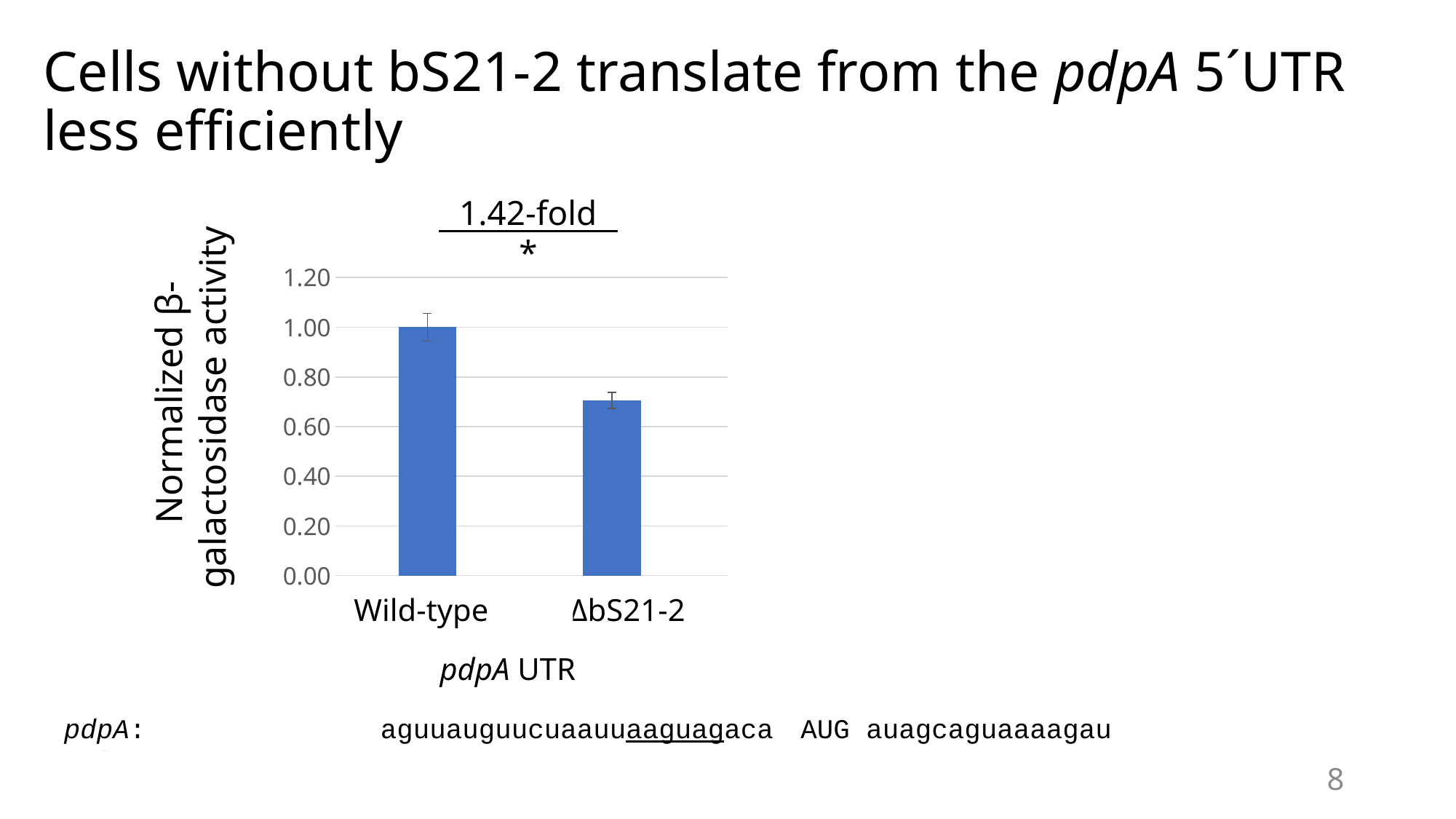
How many bars (categories) are plotted in the chart? 2 Do the values rise or fall from left to right across the x axis? fall Is the value for Wild-type greater or less than 0.80? greater Which category has the lowest normalized β-galactosidase activity? ΔbS21-2 Is the value for ΔbS21-2 greater or less than 0.80? less What fold difference is annotated above the bars in the chart? 1.42-fold What kind of chart is shown on the slide? bar chart Is the value for ΔbS21-2 greater or less than 0.60? greater Which has the larger value, Wild-type or ΔbS21-2? Wild-type What is the label of the y axis of the chart? Normalized β-galactosidase activity Which category has the highest normalized β-galactosidase activity? Wild-type What is the normalized β-galactosidase activity for Wild-type? 1.00